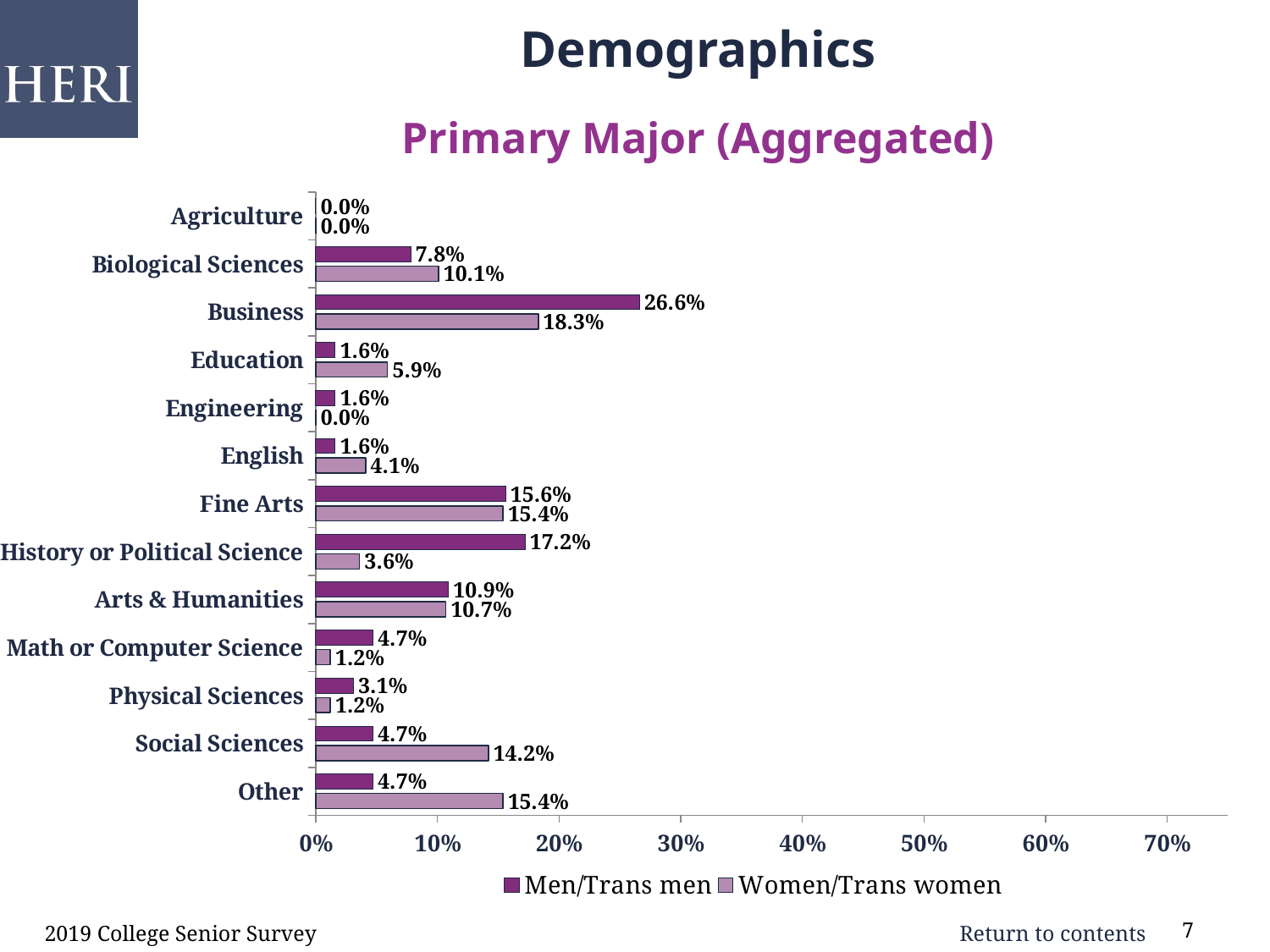
What is the difference between Men/Trans men and Women/Trans women for Business? 8.3% What is the title of the chart? Primary Major (Aggregated) What percentage of Women/Trans women have Social Sciences as their primary major? 14.2% What is the value for Women/Trans women in History or Political Science? 3.6% How many series does the legend list? 2 What is the difference between Women/Trans women and Men/Trans men for Other? 10.7% How many primary major categories are shown on the chart? 13 What percentage of Men/Trans men have Business as their primary major? 26.6% What kind of chart is shown on the slide? Bar chart Which primary major has the highest value for Men/Trans men? Business Which primary major has the highest value for Women/Trans women? Business Which is larger for Education: the Men/Trans men value or the Women/Trans women value? Women/Trans women